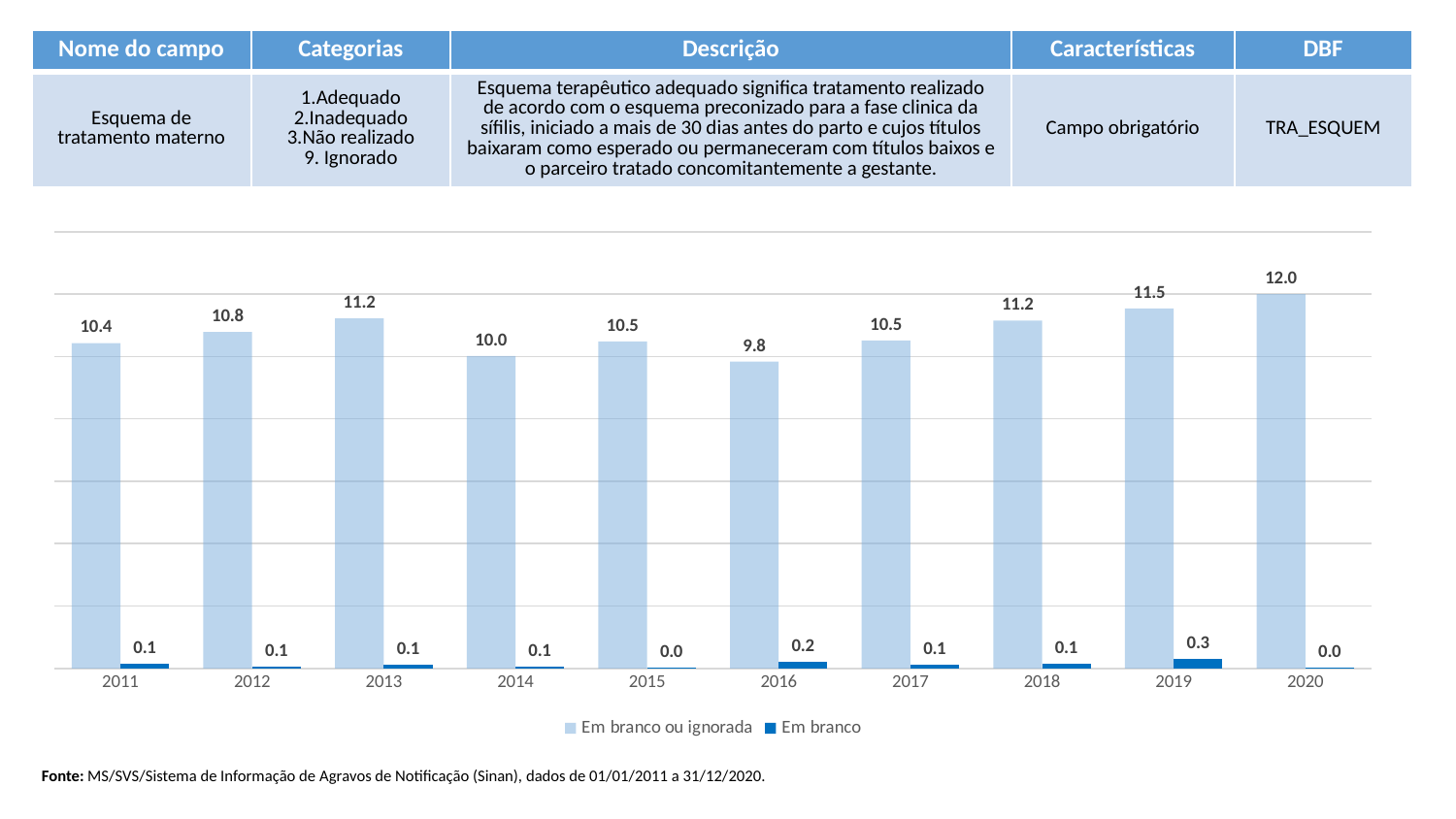
Which year has the highest value for "Em branco ou ignorada"? 2020 What is the value for "Em branco ou ignorada" in 2016? 9.8 How many series does the chart legend list? 2 Which is larger, the "Em branco ou ignorada" value for 2013 or for 2014? 2013 What is the value for "Em branco ou ignorada" in 2011? 10.4 Which year has the highest value for "Em branco"? 2019 What kind of chart is shown on the slide? Bar chart What is the value for "Em branco" in 2019? 0.3 Which year has the lowest value for "Em branco ou ignorada"? 2016 What is the difference between the "Em branco ou ignorada" values for 2020 and 2011? 1.6 How many years are shown on the x axis of the chart? 10 What is the value for "Em branco" in 2016? 0.2